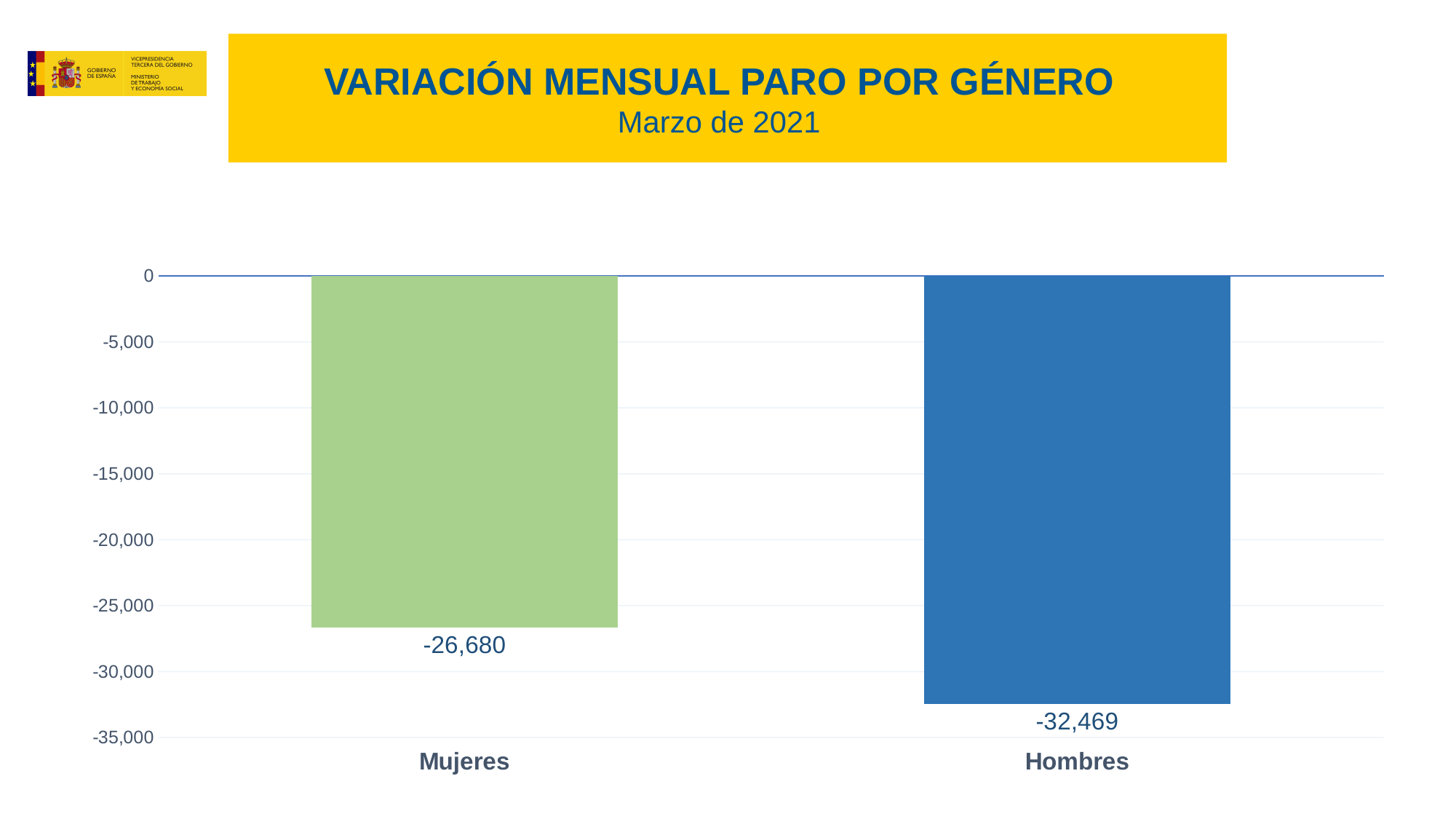
Which category shows the largest decrease (the lowest value)? Hombres What is the difference between the values for Hombres and Mujeres? 5,789 What kind of chart is shown on the slide? bar chart Is the value for Mujeres greater or less than -30,000? greater What colour is the bar for Hombres? blue How many categories are shown in the chart? 2 Which category has the highest (least negative) value? Mujeres Which value is greater, Mujeres or Hombres? Mujeres What is the value for Mujeres? -26,680 What is the value for Hombres? -32,469 What is the title of the chart? VARIACIÓN MENSUAL PARO POR GÉNERO Is the value for Hombres greater or less than -30,000? less